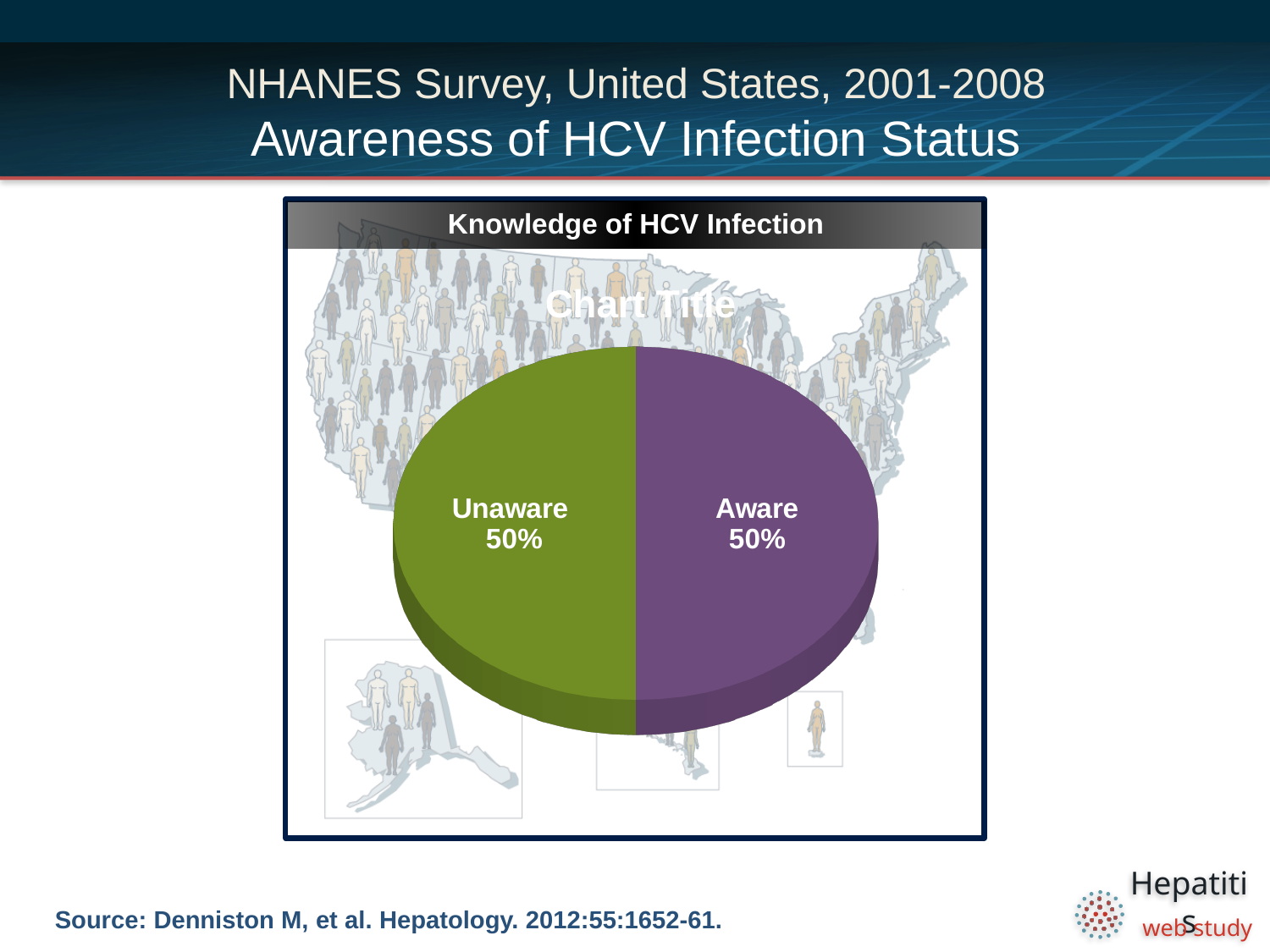
What kind of chart is shown on the slide? pie chart What is the heading printed above the pie chart? Knowledge of HCV Infection What is the difference between the Unaware and Aware percentages? 0% What colour is the Unaware slice? green What percentage of the pie is labelled Aware? 50% How many slices does the pie chart have? 2 What share of the pie does the Aware slice represent? 50% What percentage of the pie is labelled Unaware? 50%